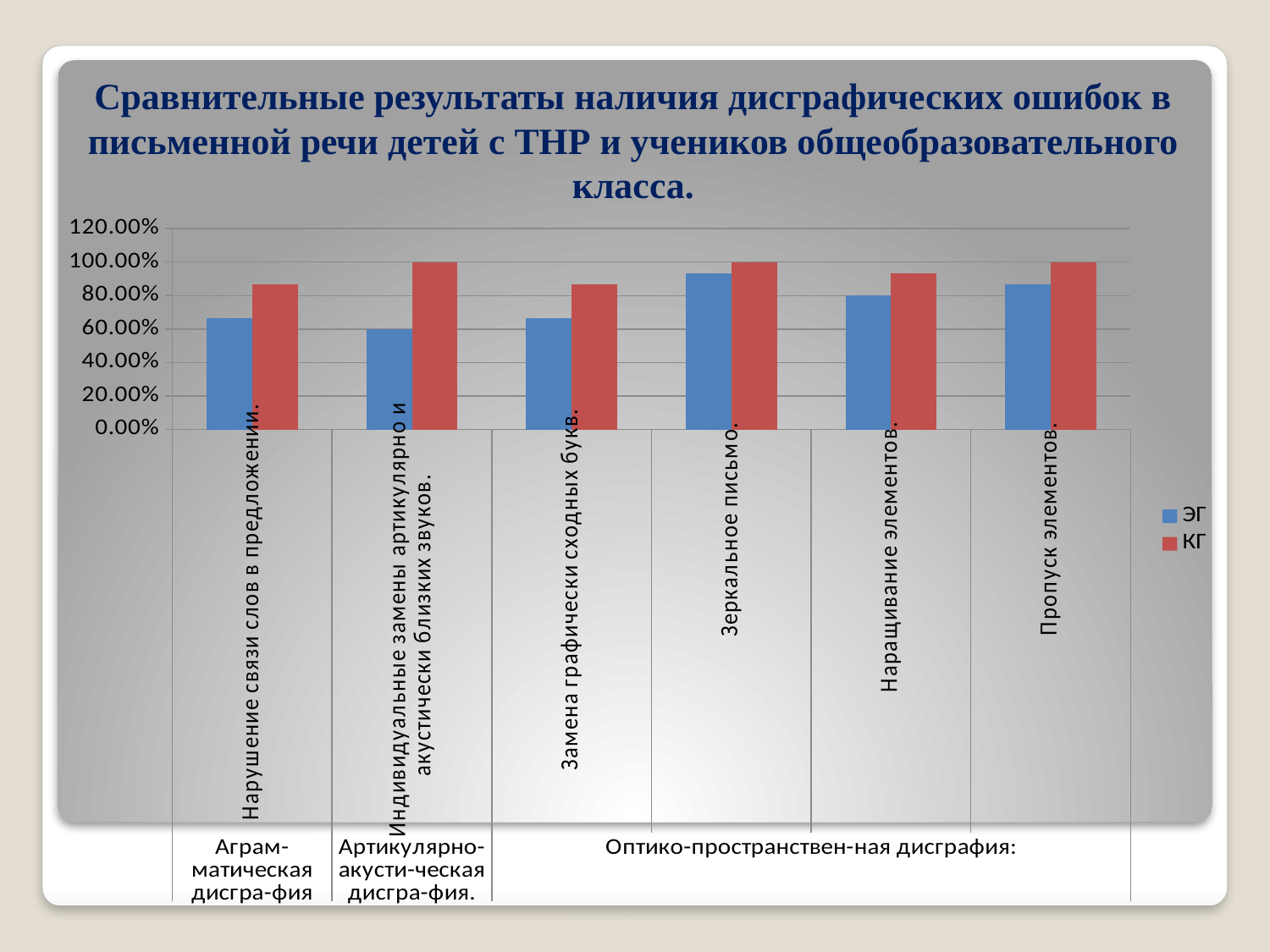
Is the КГ value for Замена графически сходных букв greater or less than 80.00%? greater Is the ЭГ value for Нарушение связи слов в предложении greater or less than 60.00%? greater How many series does the legend list? 2 How many categories are plotted along the x axis? 6 What are the two legend entries? ЭГ and КГ For Зеркальное письмо, which series has the larger value, ЭГ or КГ? КГ Is the ЭГ value for Замена графически сходных букв greater or less than 80.00%? less What kind of chart is shown on the slide? bar chart Which series is shown in blue? ЭГ Which category has the highest ЭГ value? Зеркальное письмо Which category has the lowest ЭГ value? Индивидуальные замены артикулярно и акустически близких звуков